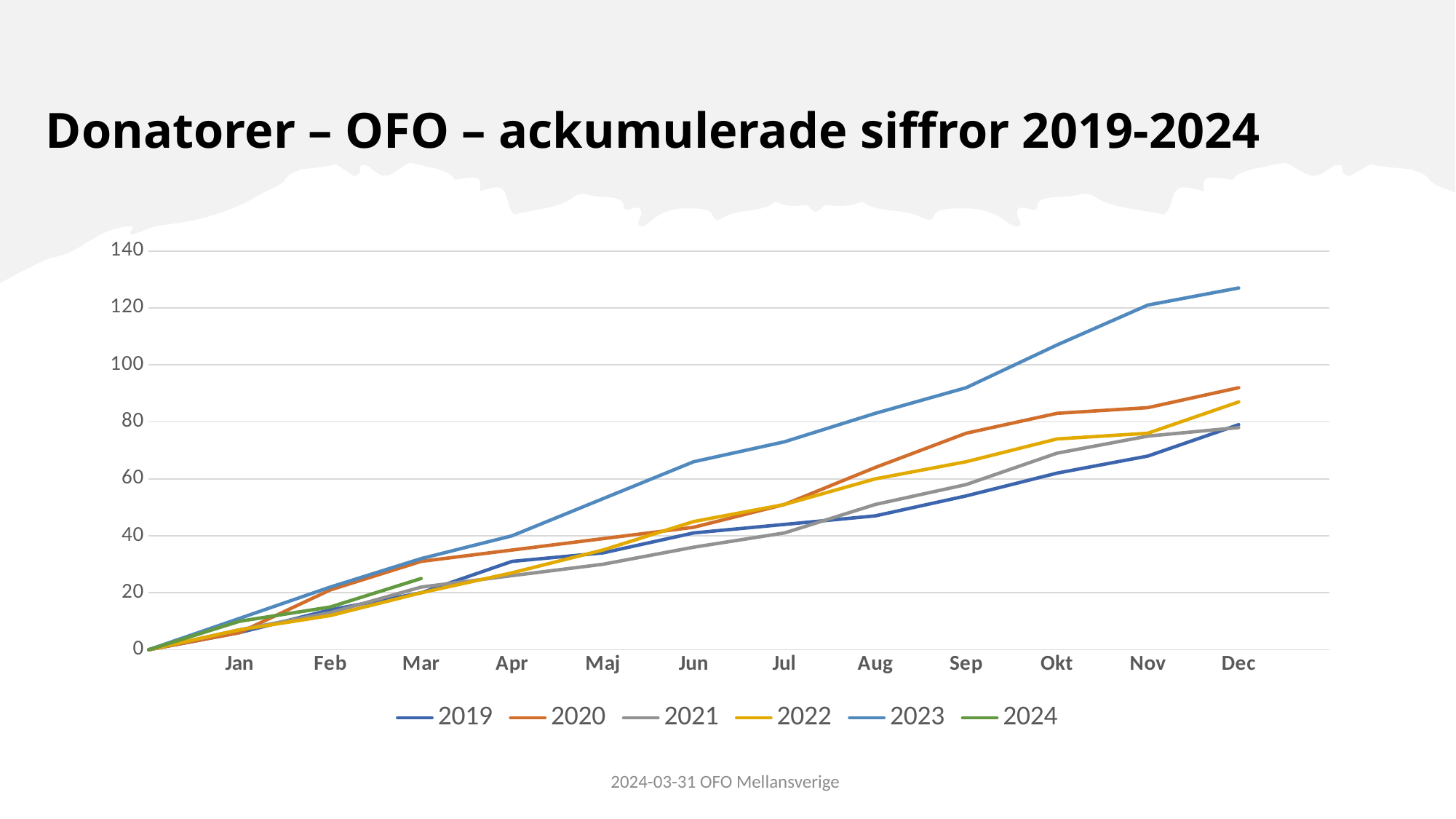
Which year's line ends in Mar rather than continuing to Dec? 2024 What is the title of the chart? Donatorer – OFO – ackumulerade siffror 2019-2024 Which is larger in Dec, the value for 2023 or the value for 2020? 2023 How many series does the legend list? 6 What kind of chart is shown on the slide? line chart How many month labels are shown on the x axis? 12 Is the value for 2020 in Dec greater or less than 80? greater Is the value for 2024 in Mar greater or less than 20? greater Which year's line is highest in Dec? 2023 Do the values for 2023 rise or fall from Jan to Dec? rise Is the value for 2023 in Jun greater or less than 60? greater